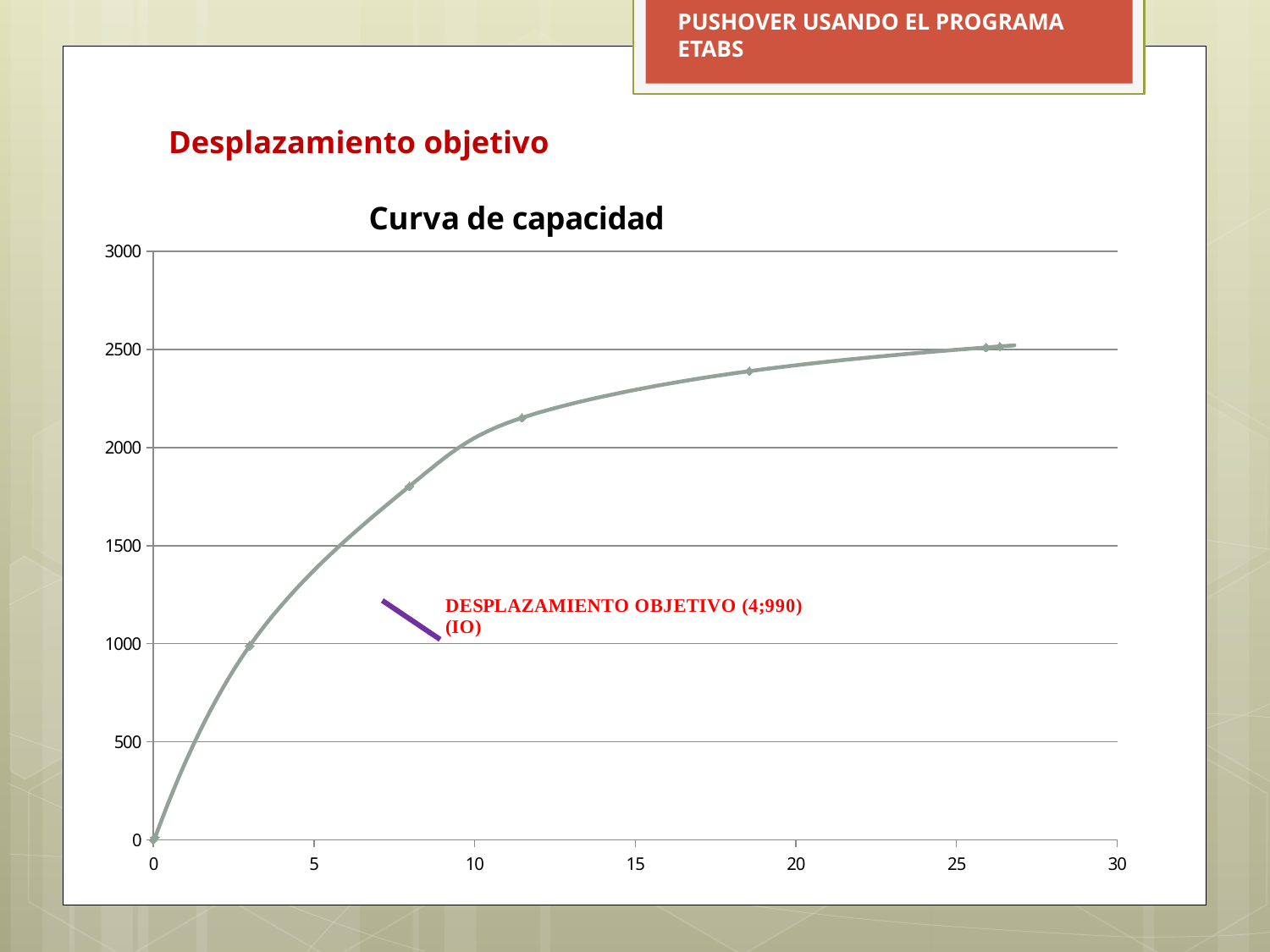
Is the value of the curve at x = 8 greater or less than 1500? greater What label in parentheses follows the desplazamiento objetivo annotation? (IO) What is the maximum value shown on the y axis? 3000 What type of chart is shown on the slide? line chart Is the value of the curve at x = 18.5 greater or less than 2000? greater Do the values on the curve rise or fall as the x axis increases? rise Is the highest value on the curve greater or less than 3000? less What is the title of the chart? Curva de capacidad What coordinates does the annotation give for the desplazamiento objetivo? (4;990) Which is larger, the value of the curve at x = 8 or at x = 3? x = 8